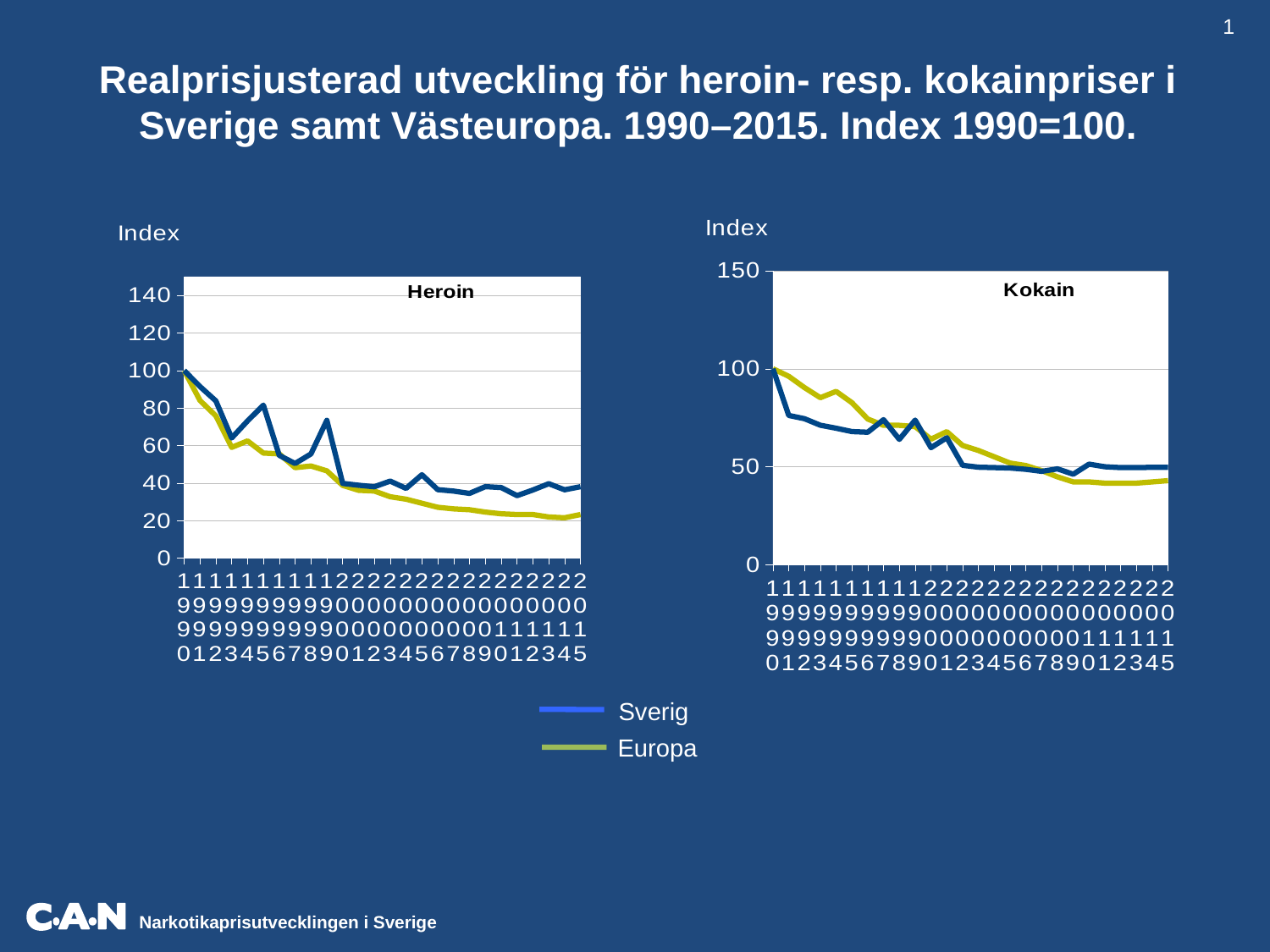
In the Heroin chart, which series has the higher value in 2015, Sverige or Europa? Sverige In the Kokain chart, is the value for Europa in 2015 greater or less than 50? less In the Heroin chart, in which year does the Sverige series reach its highest value? 1990 What kind of chart is the Heroin chart? line chart How many years are plotted along the x axis of the Kokain chart? 26 In the Heroin chart, does the Europa line rise or fall from 1990 to 2015? fall In the Kokain chart, what is the index value for Europa in 1990? 100 How many series does the legend list? 2 What are the two series named in the legend? Sverige and Europa In the Heroin chart, what is the index value for Sverige in 1990? 100 In the Heroin chart, is the value for Europa in 2015 greater or less than 40? less In the Kokain chart, which series has the higher value in 1991, Sverige or Europa? Europa